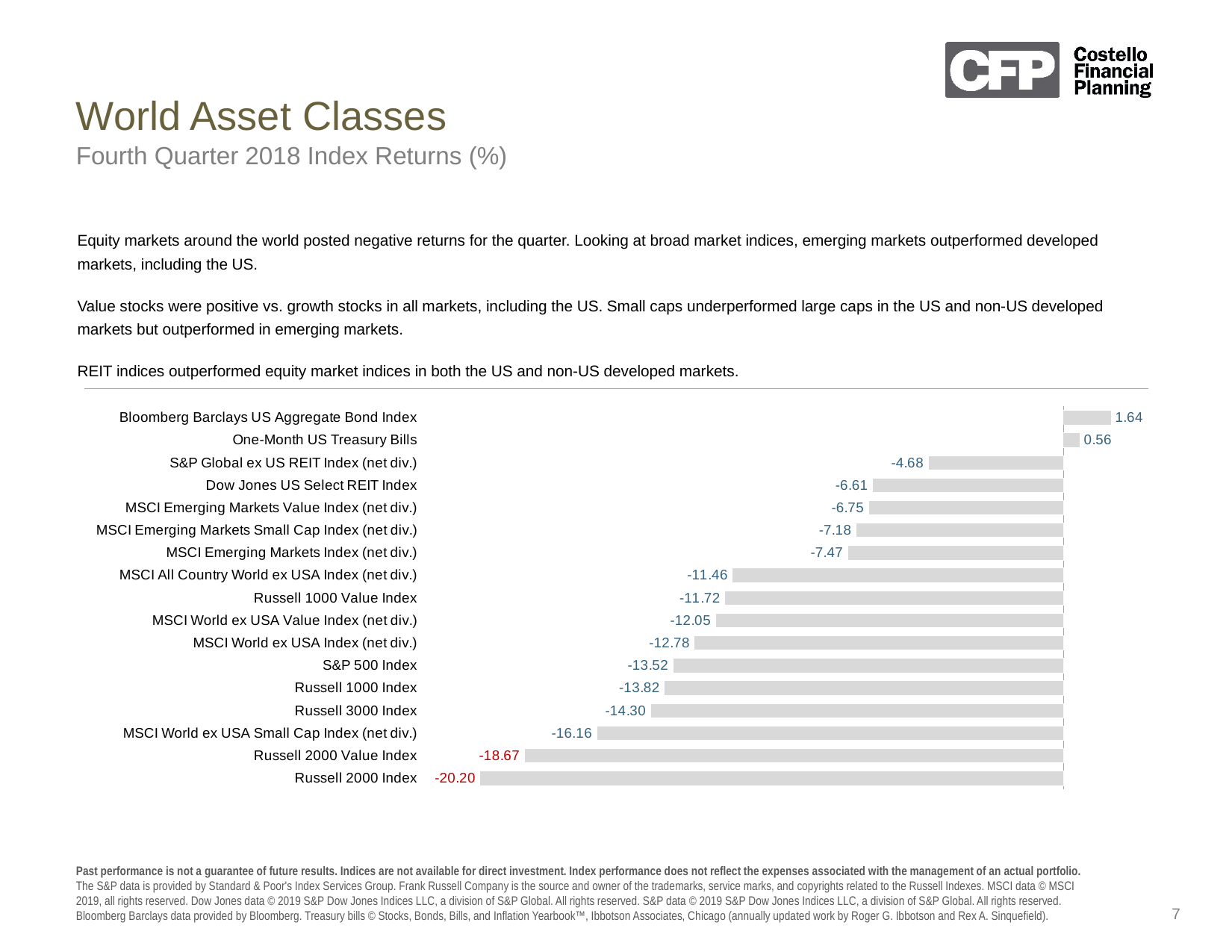
Which is larger, the value for the Russell 1000 Value Index or the Russell 1000 Index? Russell 1000 Value Index What is the value for the S&P 500 Index? -13.52 How many indices on the chart have positive values? 2 What kind of chart is shown on the slide? Bar chart What is the difference between the Dow Jones US Select REIT Index and the S&P Global ex US REIT Index (net div.) values? 1.93 What is the value for the Bloomberg Barclays US Aggregate Bond Index? 1.64 What is the value for the MSCI Emerging Markets Index (net div.)? -7.47 Which index has the lowest value on the chart? Russell 2000 Index How many indices are shown on the chart? 17 What is the difference between the Russell 2000 Value Index and the Russell 2000 Index values? 1.53 Which index has the highest value on the chart? Bloomberg Barclays US Aggregate Bond Index What is the subtitle of the chart on the slide? Fourth Quarter 2018 Index Returns (%)